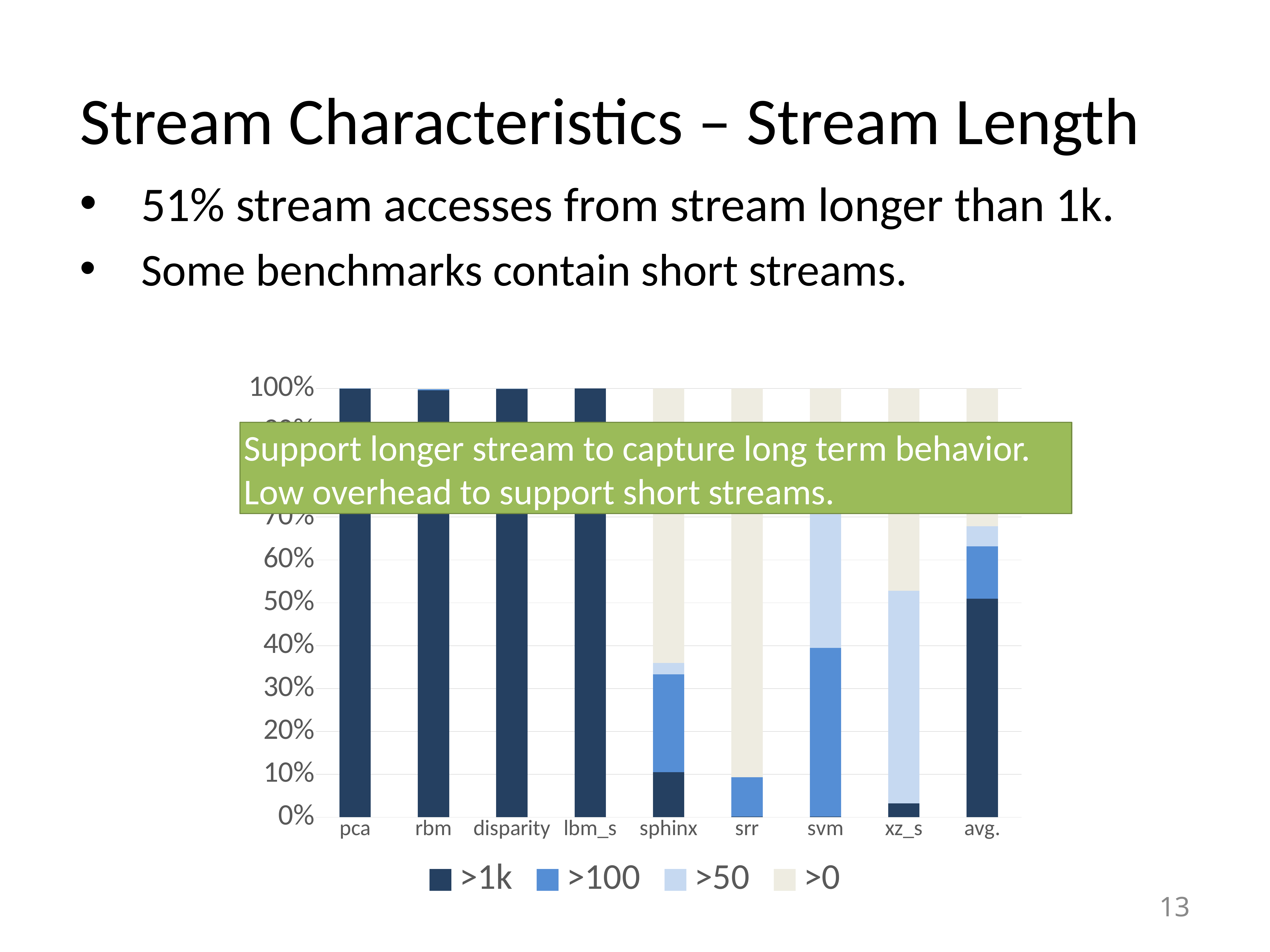
Is the >1k value for avg. greater or less than 40%? greater Which has the larger >100 segment, svm or sphinx? svm Is the >100 value for srr greater or less than 20%? less How many categories are shown along the x axis of the chart? 9 What are the four series listed in the chart's legend? >1k, >100, >50, >0 Is the >1k value for xz_s greater or less than 10%? less Which category is the last one on the x axis of the chart? avg. What kind of chart is shown on the slide? stacked bar chart Which has the larger >1k segment, pca or sphinx? pca How many series does the chart's legend list? 4